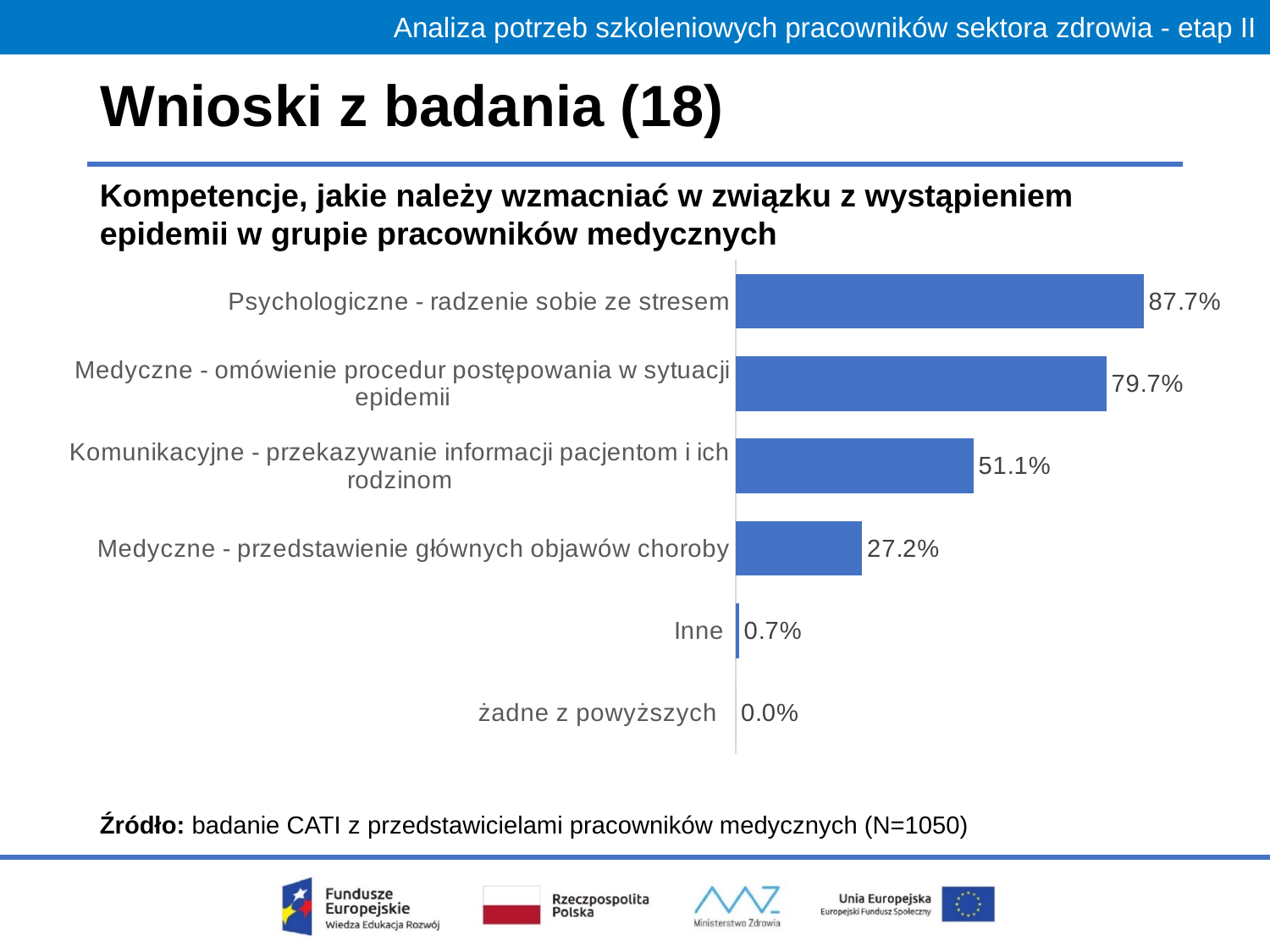
Which is larger: the value for "Medyczne - omówienie procedur postępowania w sytuacji epidemii" or for "Komunikacyjne - przekazywanie informacji pacjentom i ich rodzinom"? Medyczne - omówienie procedur postępowania w sytuacji epidemii What is the value for "Inne"? 0.7% What is the difference between the values for "Psychologiczne - radzenie sobie ze stresem" and "Medyczne - omówienie procedur postępowania w sytuacji epidemii"? 8.0% What is the sample size (N) given in the source note below the chart? N=1050 What is the difference between the values for "Komunikacyjne - przekazywanie informacji pacjentom i ich rodzinom" and "Medyczne - przedstawienie głównych objawów choroby"? 23.9% How many categories are shown in the chart? 6 What is the value for "Komunikacyjne - przekazywanie informacji pacjentom i ich rodzinom"? 51.1% Which category has the lowest value? żadne z powyższych What is the value for "Psychologiczne - radzenie sobie ze stresem"? 87.7% What is the value for "Medyczne - przedstawienie głównych objawów choroby"? 27.2% What kind of chart is shown on the slide? Bar chart Which category has the highest value? Psychologiczne - radzenie sobie ze stresem